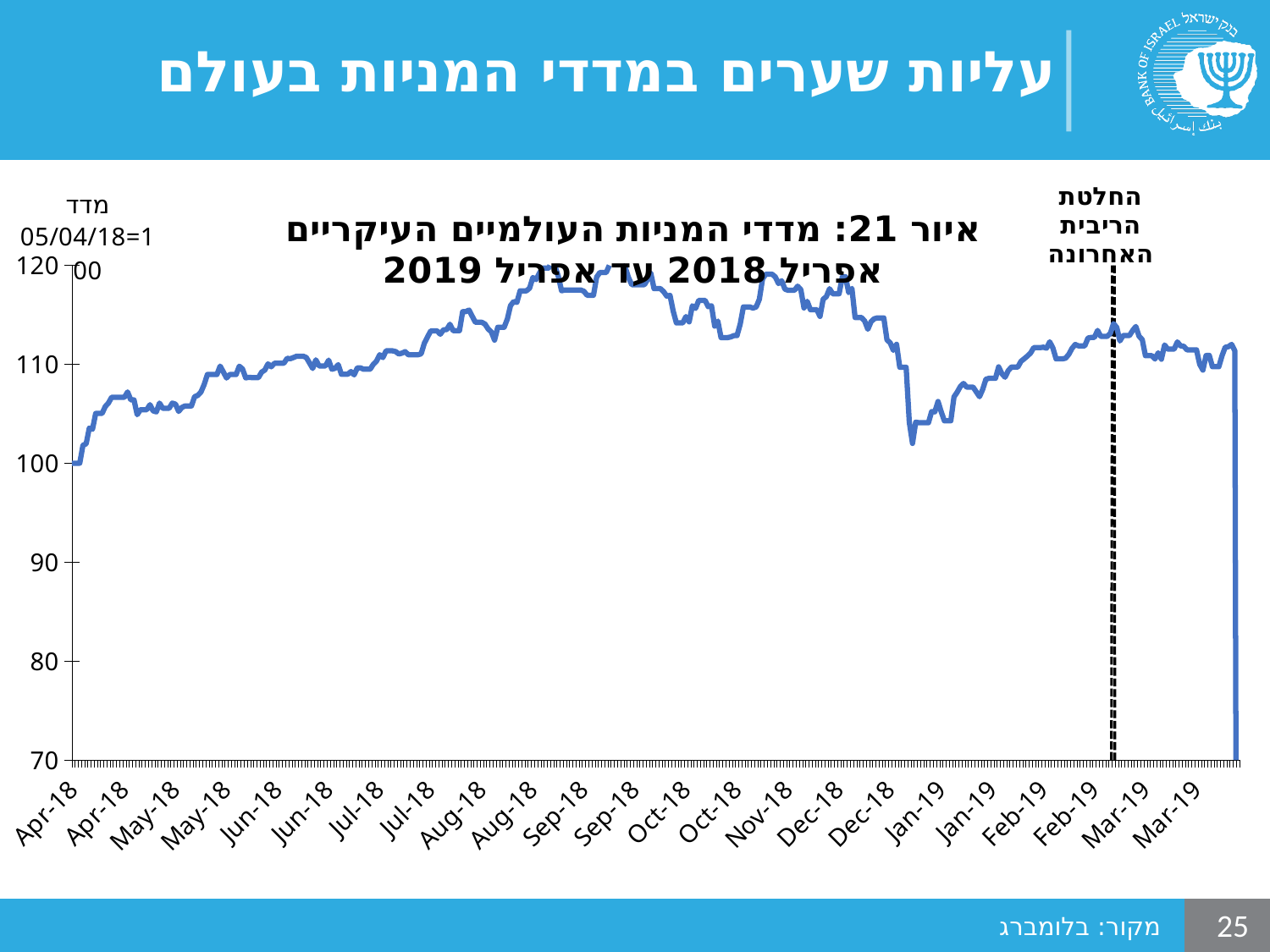
What does the dashed vertical line on the chart mark? החלטת הריבית האחרונה Is the index value around Jun-18 greater or less than 120? less What is the title of the chart? איור 21: מדדי המניות העולמיים העיקריים אפריל 2018 עד אפריל 2019 Is the index value around Mar-19 greater or less than 110? greater What is the index value on the base date 05/04/18? 100 Does the index rise or fall between Apr-18 and Sep-18? rise Does the index rise or fall between Oct-18 and late Dec-18? fall Is the index value at the low point in late Dec-18 greater or less than 110? less What kind of chart is shown on the slide? line chart Is the index value around Sep-18 larger or smaller than the value around Jan-19? larger Around which month does the index reach its highest level? Sep-18